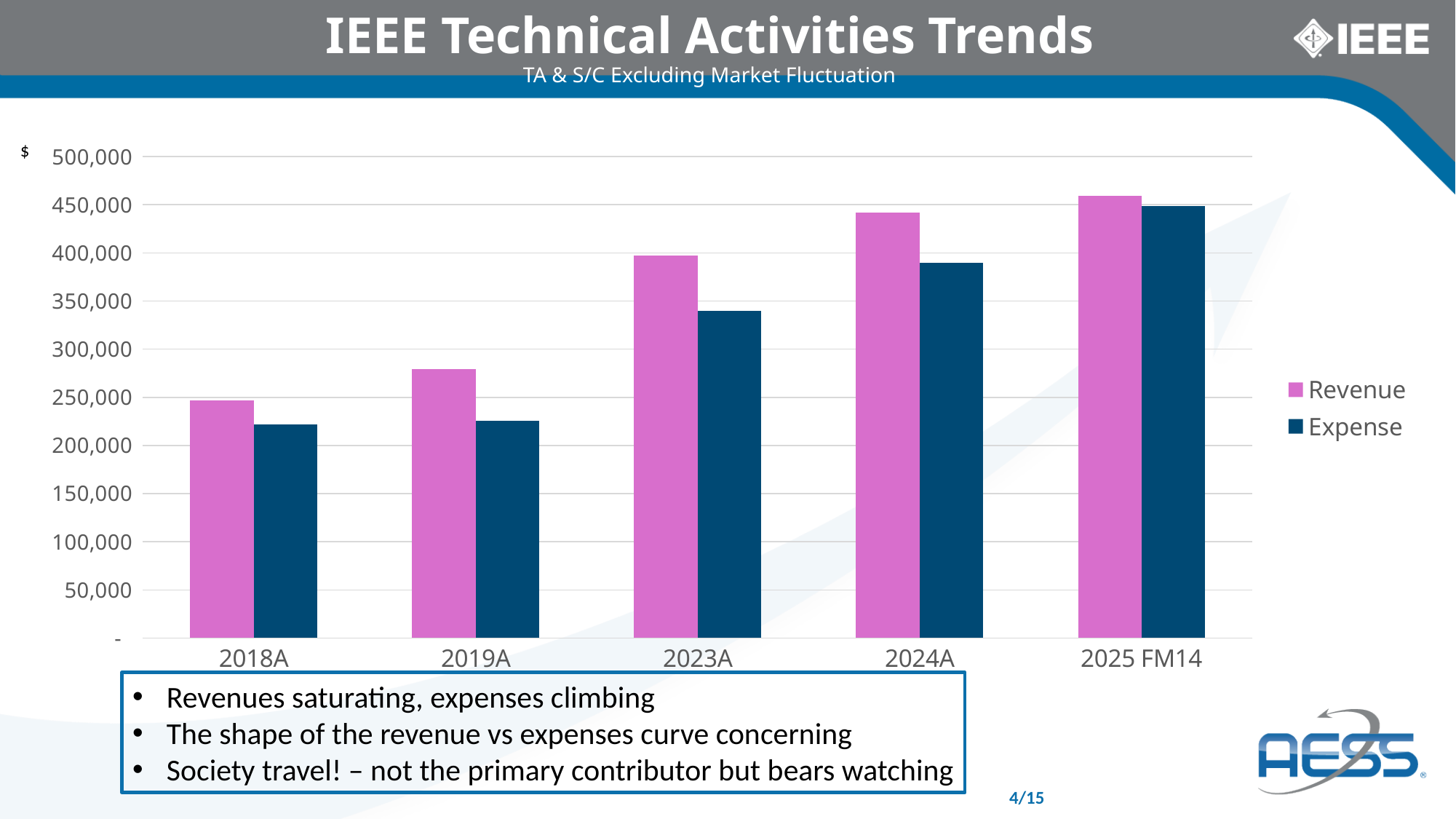
Is the Expense value for 2018A greater or less than 250,000? less How many year categories are shown on the x axis? 5 What colour are the Expense bars? dark blue Which year has the highest Expense? 2025 FM14 Does Revenue rise or fall from 2018A to 2025 FM14? rise Which year has the lowest Revenue? 2018A In 2023A, which is larger, Revenue or Expense? Revenue Which year has the highest Revenue? 2025 FM14 Is the Revenue value for 2023A greater or less than 350,000? greater How many series does the legend list? 2 What kind of chart is shown on the slide? bar chart Is the Expense value for 2024A greater or less than 400,000? less